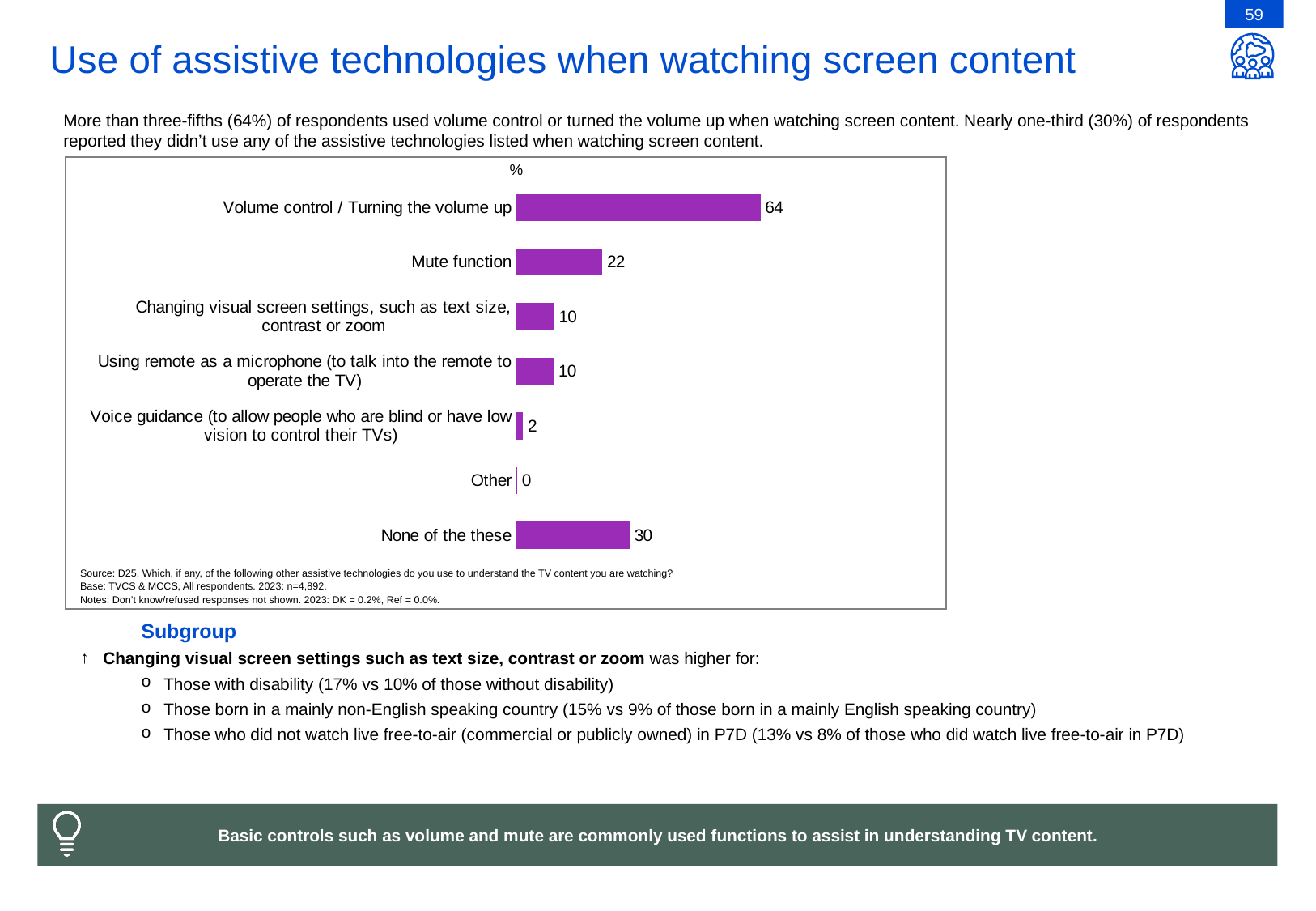
What is the value for Other? 0 What is the value for Voice guidance (to allow people who are blind or have low vision to control their TVs)? 2 What colour are the bars in the chart? Purple What is the difference between the values for Volume control / Turning the volume up and Mute function? 42 What is the value for Volume control / Turning the volume up? 64 Which category has the lowest value? Other What is the value for Mute function? 22 How many categories are shown in the chart? 7 What kind of chart is shown on the slide? Bar chart Which is larger, the value for Mute function or the value for None of the these? None of the these What is the value for None of the these? 30 Which category has the highest value? Volume control / Turning the volume up